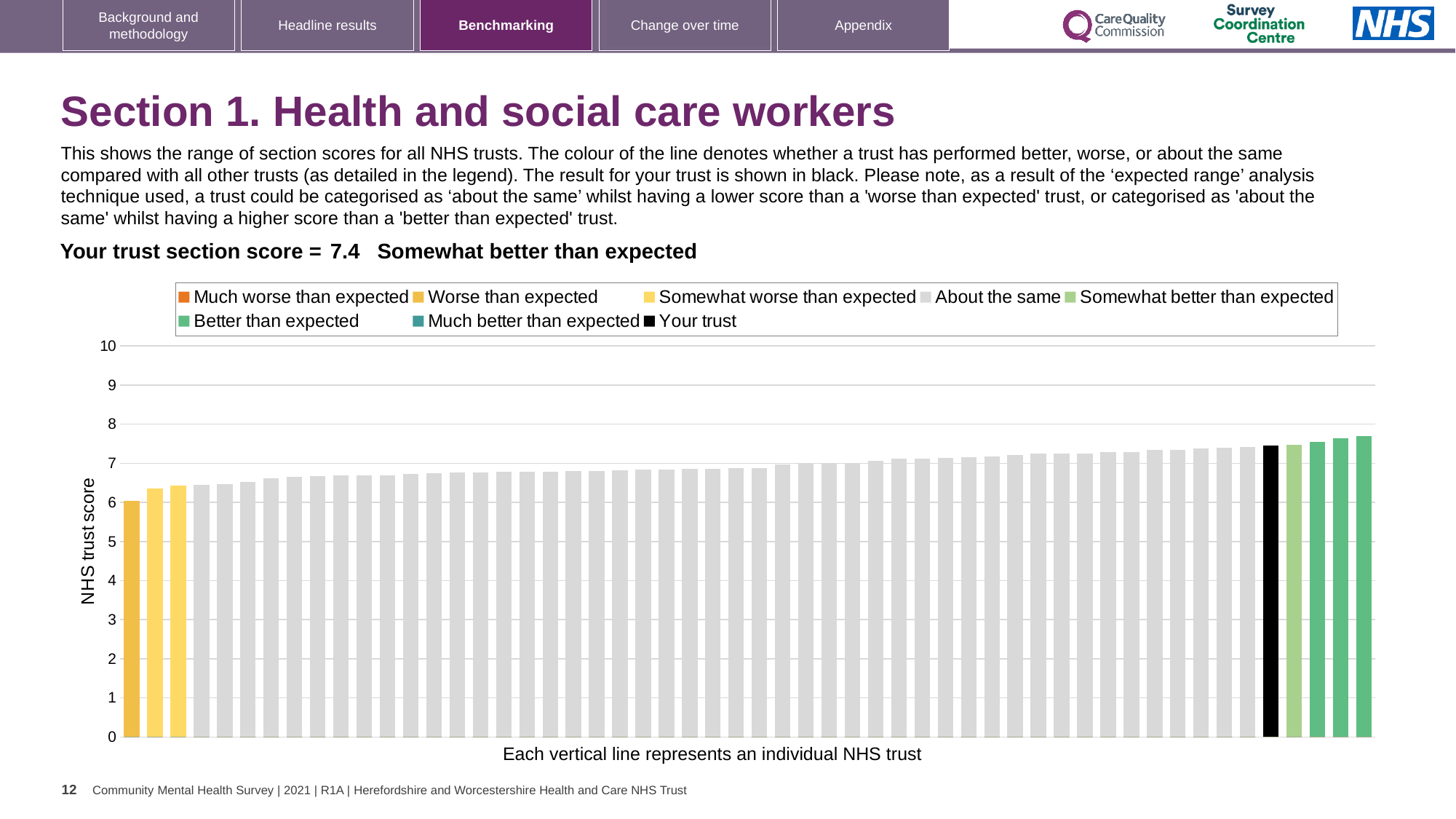
Is the value for your trust (the black bar) greater or less than 7? greater What is the maximum value shown on the vertical axis? 10 What kind of chart is shown on the slide? bar chart What is the label on the vertical axis of the chart? NHS trust score Is the value of the shortest bar greater or less than 7? less Do the bar values rise or fall from left to right along the x axis? rise Which legend category does the black bar represent? Your trust How many entries does the chart legend list? 8 How many bars are coloured yellow (worse than expected)? 3 What is the section score for your trust (the black bar)? 7.4 How many bars are coloured green (somewhat better or better than expected)? 4 Is the value of the tallest bar greater or less than 8? less